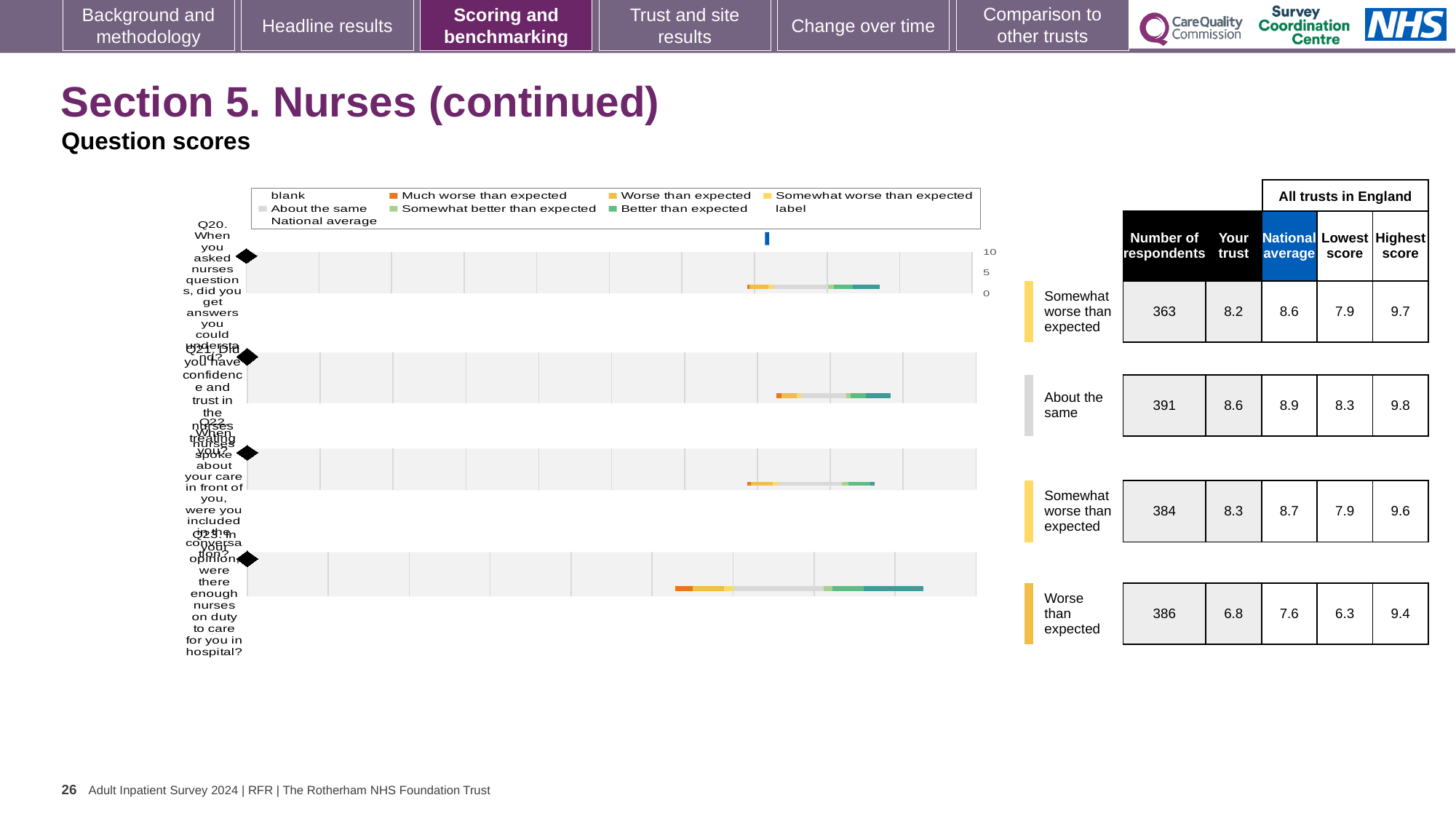
Which question has the lowest 'Your trust' score? Q23 Which question has the highest national average? Q21 What kind of chart is used to show the question scores on this slide? Bar chart How many questions (Q20 to Q23) are plotted in the chart? 4 Which has the higher 'Your trust' score, Q20 or Q22? Q22 What is the 'Your trust' score for Q23 (were there enough nurses on duty)? 6.8 What is the national average for Q21 (confidence and trust in the nurses)? 8.9 How many respondents answered Q22 (nurses speaking about your care in front of you)? 384 What benchmark category is Q23 placed in? Worse than expected What is the highest score across all trusts in England for Q20? 9.7 For Q23, how much lower is the 'Your trust' score than the national average? 0.8 What is the maximum value shown on the chart's score axis? 10